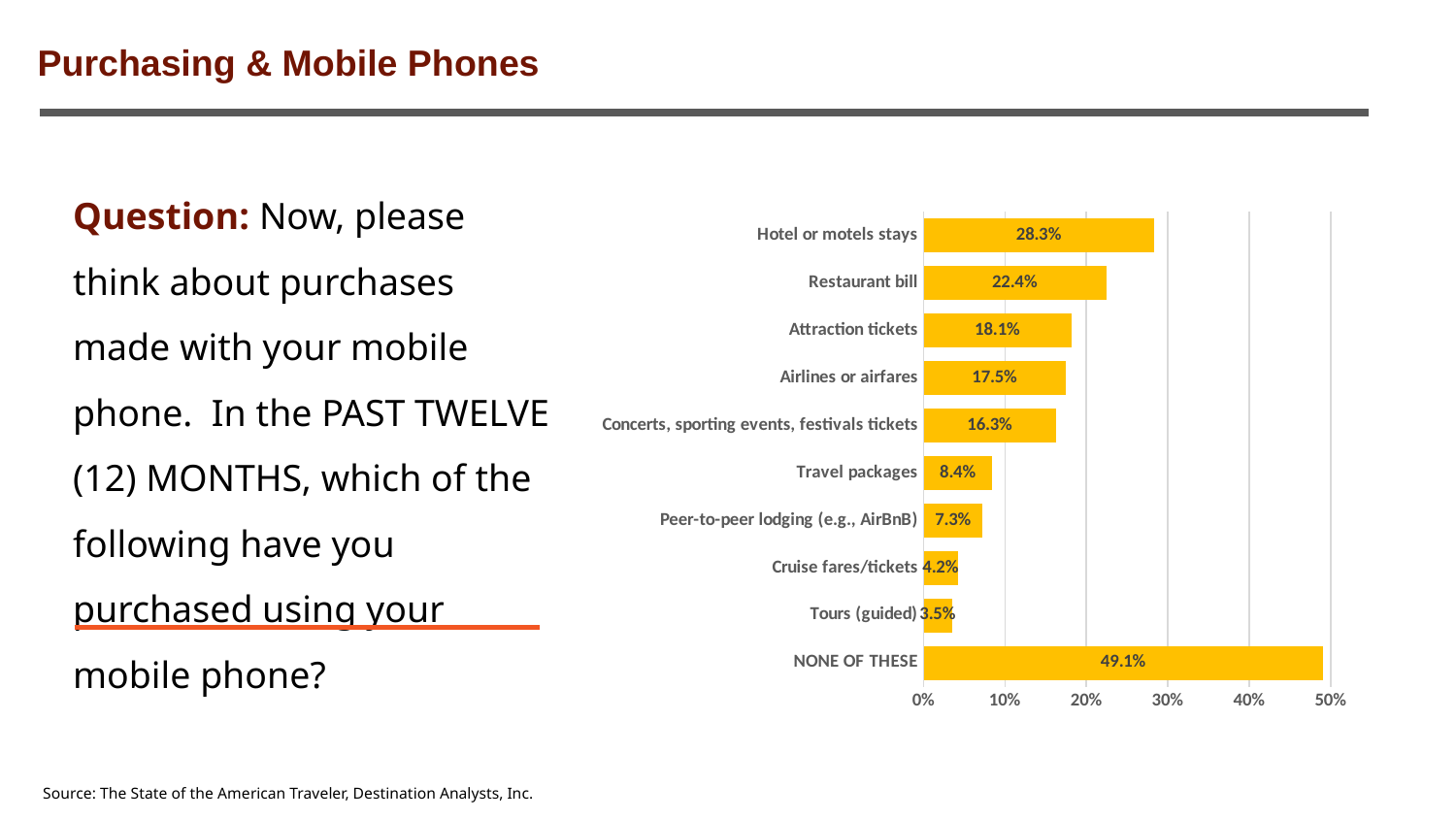
Which is larger, the value for Attraction tickets or the value for Airlines or airfares? Attraction tickets How many categories are shown in the chart? 10 What is the highest value labelled on the horizontal axis of the chart? 50% What is the difference between the values for Hotel or motels stays and Restaurant bill? 5.9% What kind of chart is shown on the slide? Bar chart Which category has the highest value in the chart? NONE OF THESE What is the difference between the values for Travel packages and Cruise fares/tickets? 4.2% Is the value for NONE OF THESE greater or less than 40%? greater What is the value shown for Peer-to-peer lodging (e.g., AirBnB)? 7.3% Which category has the lowest value in the chart? Tours (guided) What is the value shown for Restaurant bill? 22.4% What percentage of respondents purchased hotel or motel stays using their mobile phone? 28.3%